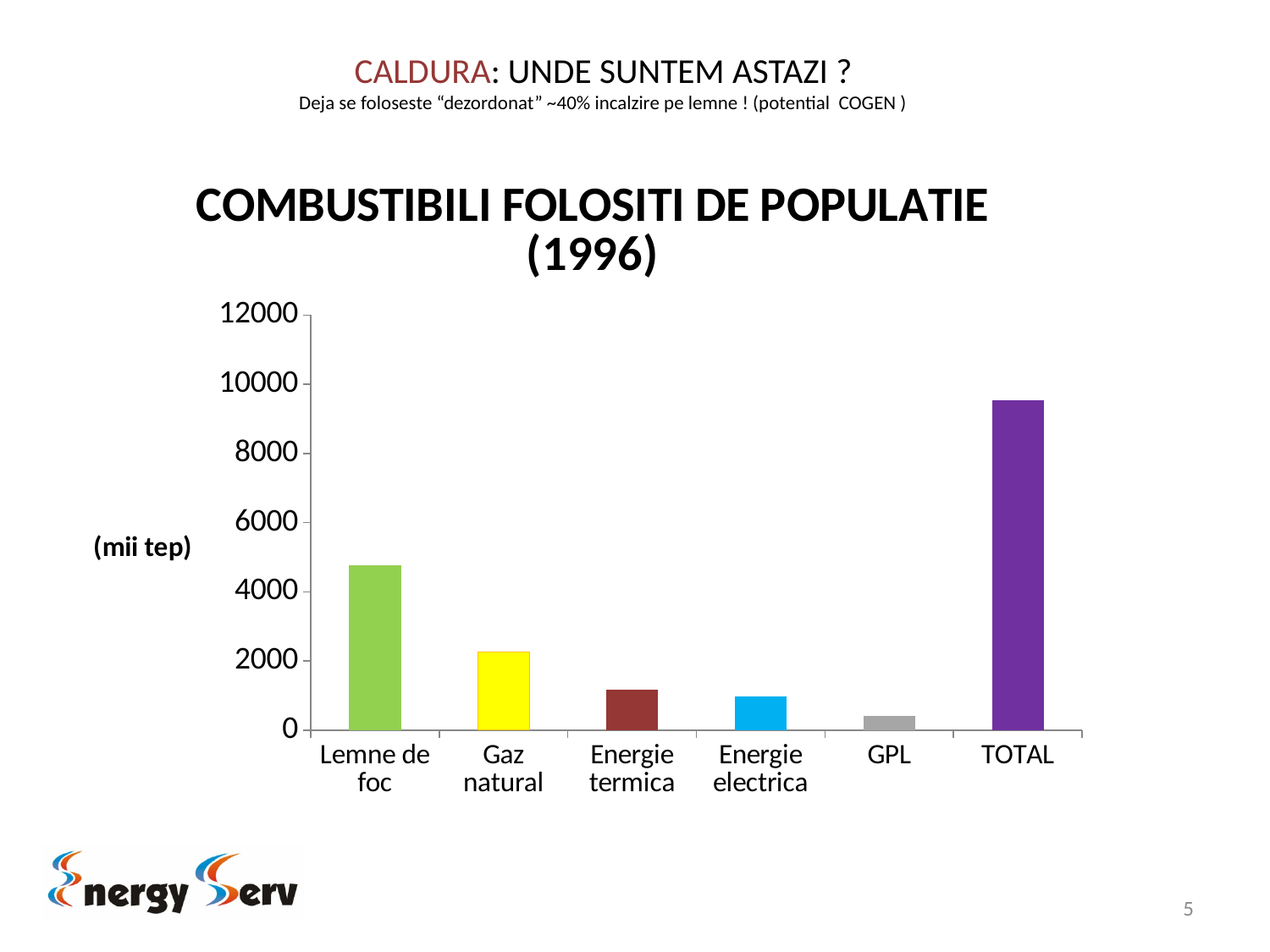
Is the value for Lemne de foc greater or less than 4000? greater Which category has the tallest bar in the chart? TOTAL Which category has the shortest bar in the chart? GPL Which is larger, the value for Gaz natural or the value for GPL? Gaz natural Is the value for TOTAL greater or less than 8000? greater What kind of chart is shown on the slide? bar chart Which is larger, the value for Lemne de foc or the value for Gaz natural? Lemne de foc How many categories are shown on the x axis of the chart? 6 Is the value for GPL greater or less than 2000? less Excluding TOTAL, which fuel category has the highest value? Lemne de foc What is the title of the chart? COMBUSTIBILI FOLOSITI DE POPULATIE (1996) What unit is shown next to the vertical axis of the chart? (mii tep)